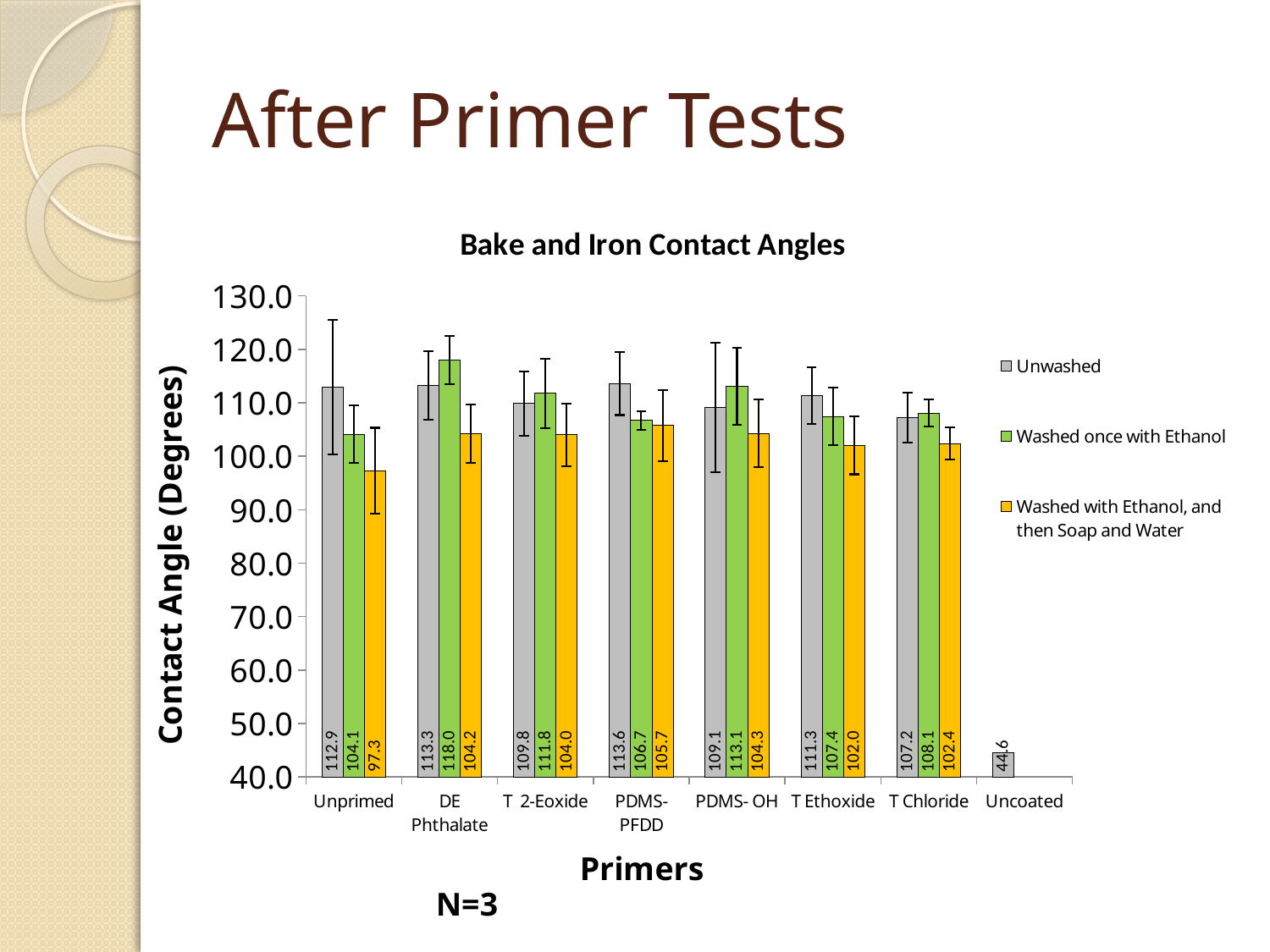
For DE Phthalate, what is the difference between the Washed once with Ethanol value and the Washed with Ethanol, and then Soap and Water value? 13.8 What is the title of the chart? Bake and Iron Contact Angles What is the value for T Chloride in the Washed with Ethanol, and then Soap and Water series? 102.4 Is the Unwashed value for Uncoated greater or less than 50.0? less Which primer has the lowest value in the Washed with Ethanol, and then Soap and Water series? Unprimed For PDMS-PFDD, which is larger: the Unwashed value or the Washed once with Ethanol value? Unwashed Which primer has the highest value in the Washed once with Ethanol series? DE Phthalate What is the value for DE Phthalate in the Washed once with Ethanol series? 118.0 How many series does the legend list? 3 What is the Unwashed contact angle for the Uncoated sample? 44.6 How many primer categories are shown on the x axis? 8 What is the Unwashed contact angle for the Unprimed primer? 112.9